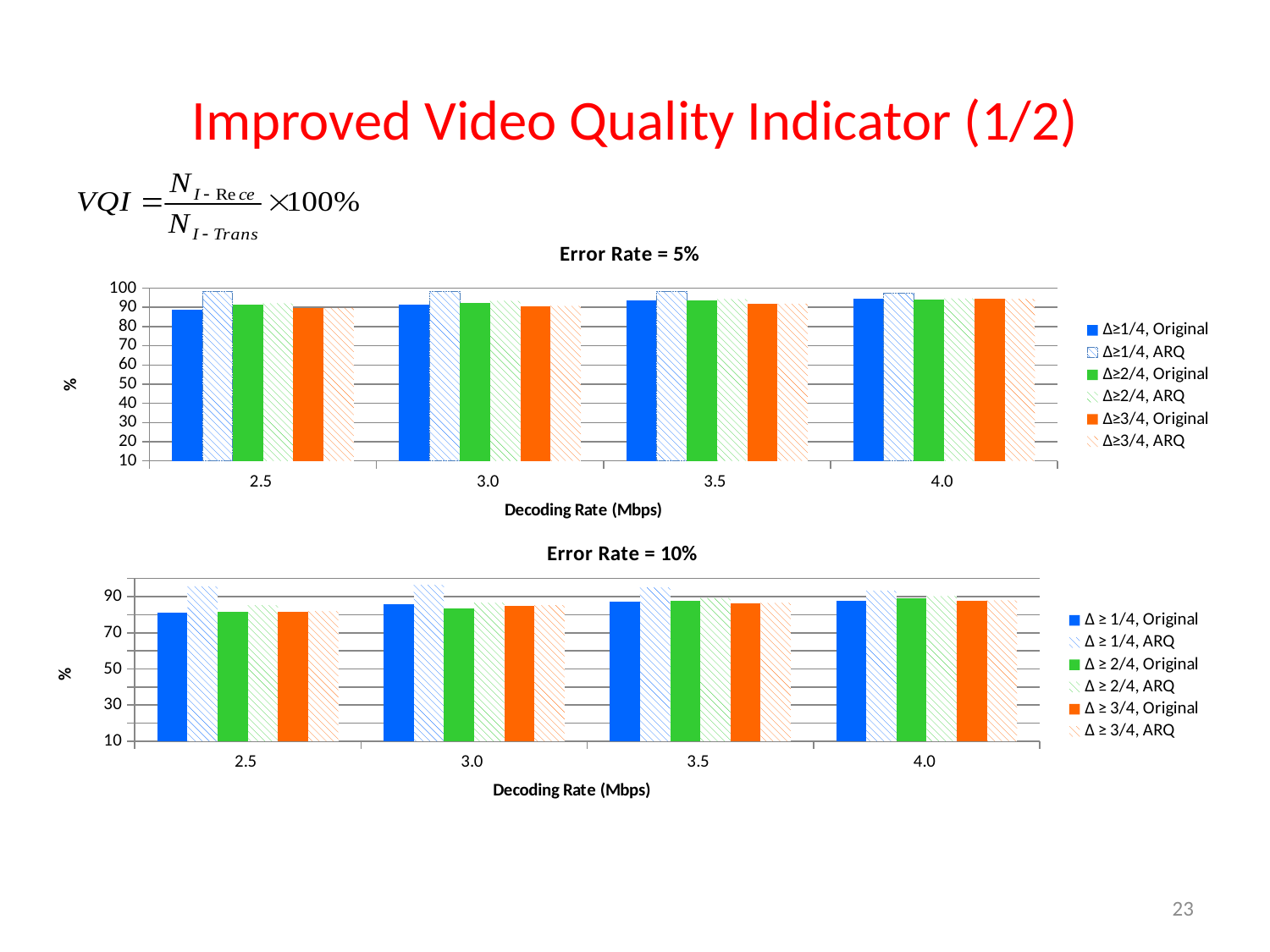
In the "Error Rate = 10%" chart, at which decoding rate is the value for Δ ≥ 1/4, Original lowest? 2.5 In the "Error Rate = 5%" chart, is the value for Δ≥1/4, ARQ at 2.5 Mbps greater or less than 90? greater In the "Error Rate = 10%" chart, at 3.0 Mbps, which is larger: Δ ≥ 1/4, ARQ or Δ ≥ 2/4, Original? Δ ≥ 1/4, ARQ How many decoding rate categories are shown on the x axis of the "Error Rate = 10%" chart? 4 In the "Error Rate = 10%" chart, does the value for Δ ≥ 1/4, Original rise or fall as the decoding rate increases from 2.5 to 4.0 Mbps? rise In the "Error Rate = 10%" chart, is the value for Δ ≥ 3/4, Original at 2.5 Mbps greater or less than 70? greater What is the x-axis label of the "Error Rate = 10%" chart? Decoding Rate (Mbps) How many series does the legend of the "Error Rate = 5%" chart list? 6 What kind of chart is the "Error Rate = 5%" chart? bar chart What is the title of the upper chart on the slide? Error Rate = 5% In the "Error Rate = 10%" chart, is the value for Δ ≥ 1/4, Original at 2.5 Mbps greater or less than 90? less In the "Error Rate = 5%" chart, at 2.5 Mbps, which is larger: Δ≥1/4, Original or Δ≥1/4, ARQ? Δ≥1/4, ARQ